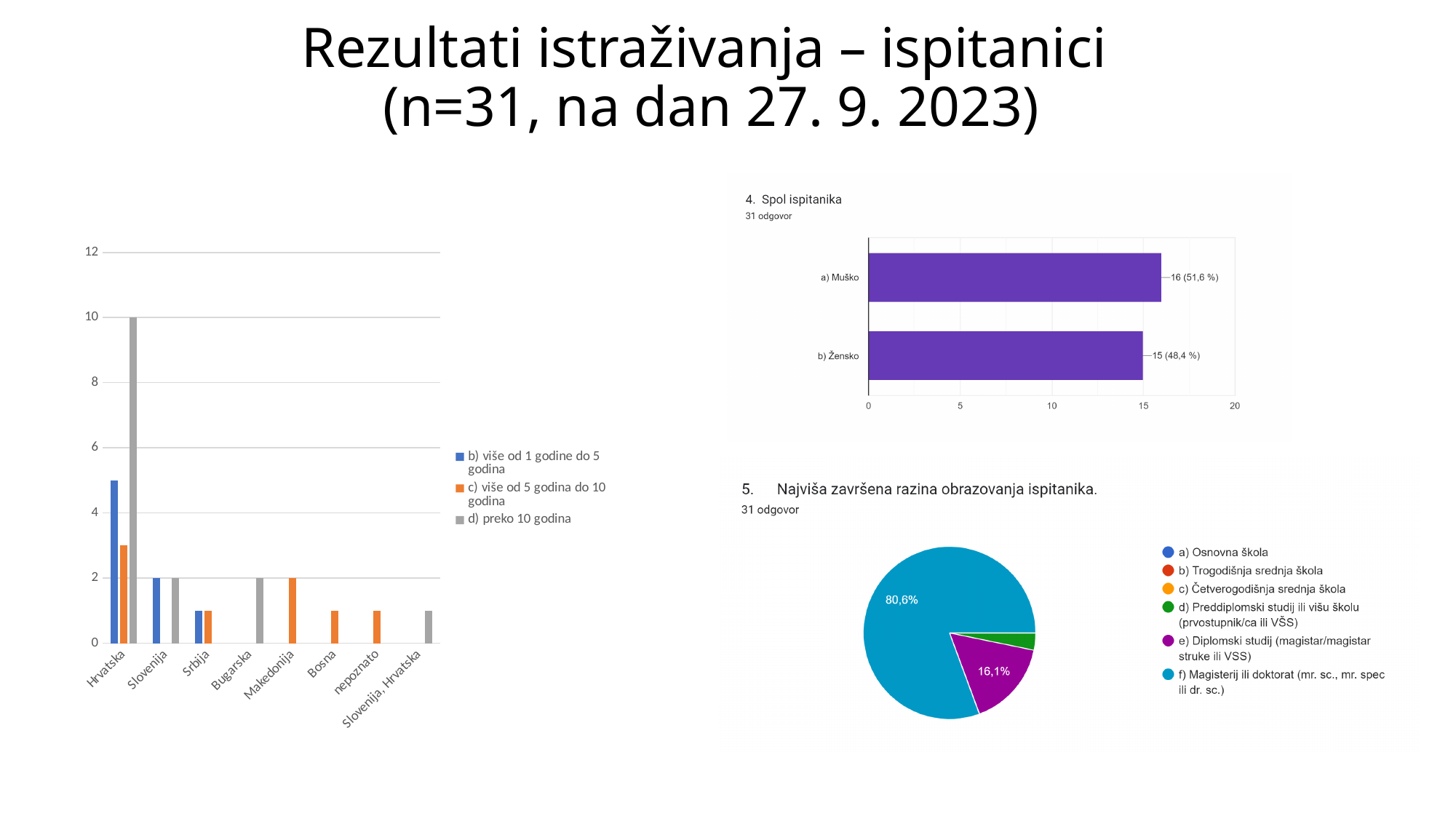
In the bar chart on the left of the slide, how many series does the legend list? 3 What kind of chart is the one titled '4. Spol ispitanika'? Bar chart In the bar chart on the left of the slide, is the value of the 'b) više od 1 godine do 5 godina' bar for Hrvatska greater or less than 4? greater In the chart titled '4. Spol ispitanika', what is the value for b) Žensko? 15 (48,4 %) In the pie chart titled '5. Najviša završena razina obrazovanja ispitanika', what share does e) Diplomski studij have? 16,1% In the chart titled '4. Spol ispitanika', what is the difference between the counts for a) Muško and b) Žensko? 1 In the chart titled '4. Spol ispitanika', which category has the higher count? a) Muško In the bar chart on the left of the slide, what is the value of the 'd) preko 10 godina' bar for Hrvatska? 10 In the pie chart titled '5. Najviša završena razina obrazovanja ispitanika', what share does f) Magisterij ili doktorat have? 80,6% How many entries does the legend of the pie chart titled '5. Najviša završena razina obrazovanja ispitanika' list? 6 In the bar chart on the left of the slide, how many categories are shown on the x axis? 8 In the chart titled '4. Spol ispitanika', what is the value for a) Muško? 16 (51,6 %)